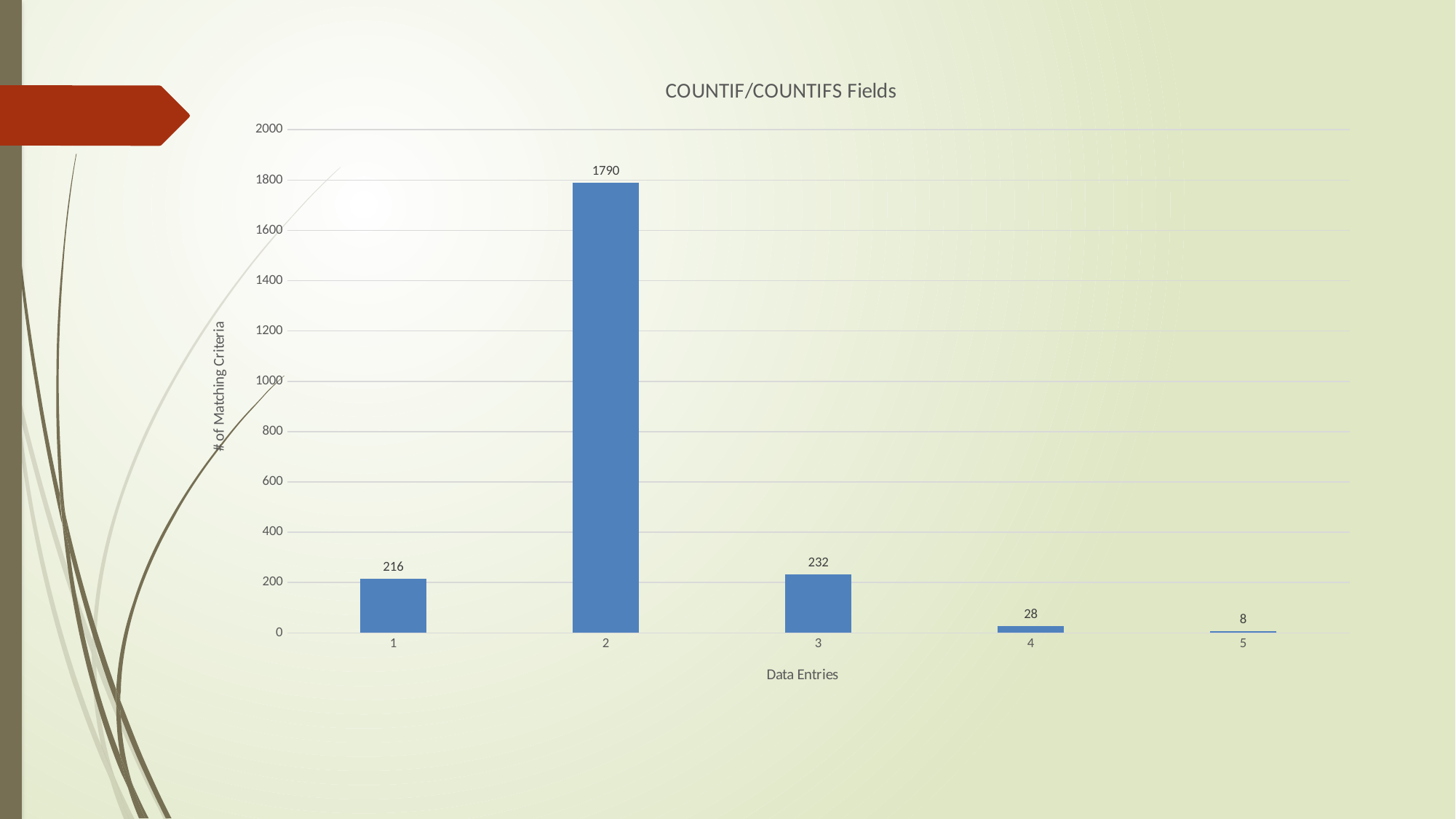
How many data entries are shown on the x axis? 5 What kind of chart is shown? bar chart Which data entry has the highest number of matching criteria? 2 Is the value for data entry 2 greater or less than 1600? greater What is the difference between the values for data entries 2 and 3? 1558 What is the value for data entry 2? 1790 Which is larger, the value for data entry 4 or data entry 5? 4 Which data entry has the lowest number of matching criteria? 5 What is the difference between the values for data entries 3 and 1? 16 What is the value for data entry 5? 8 What is the value for data entry 1? 216 What is the title of the chart? COUNTIF/COUNTIFS Fields